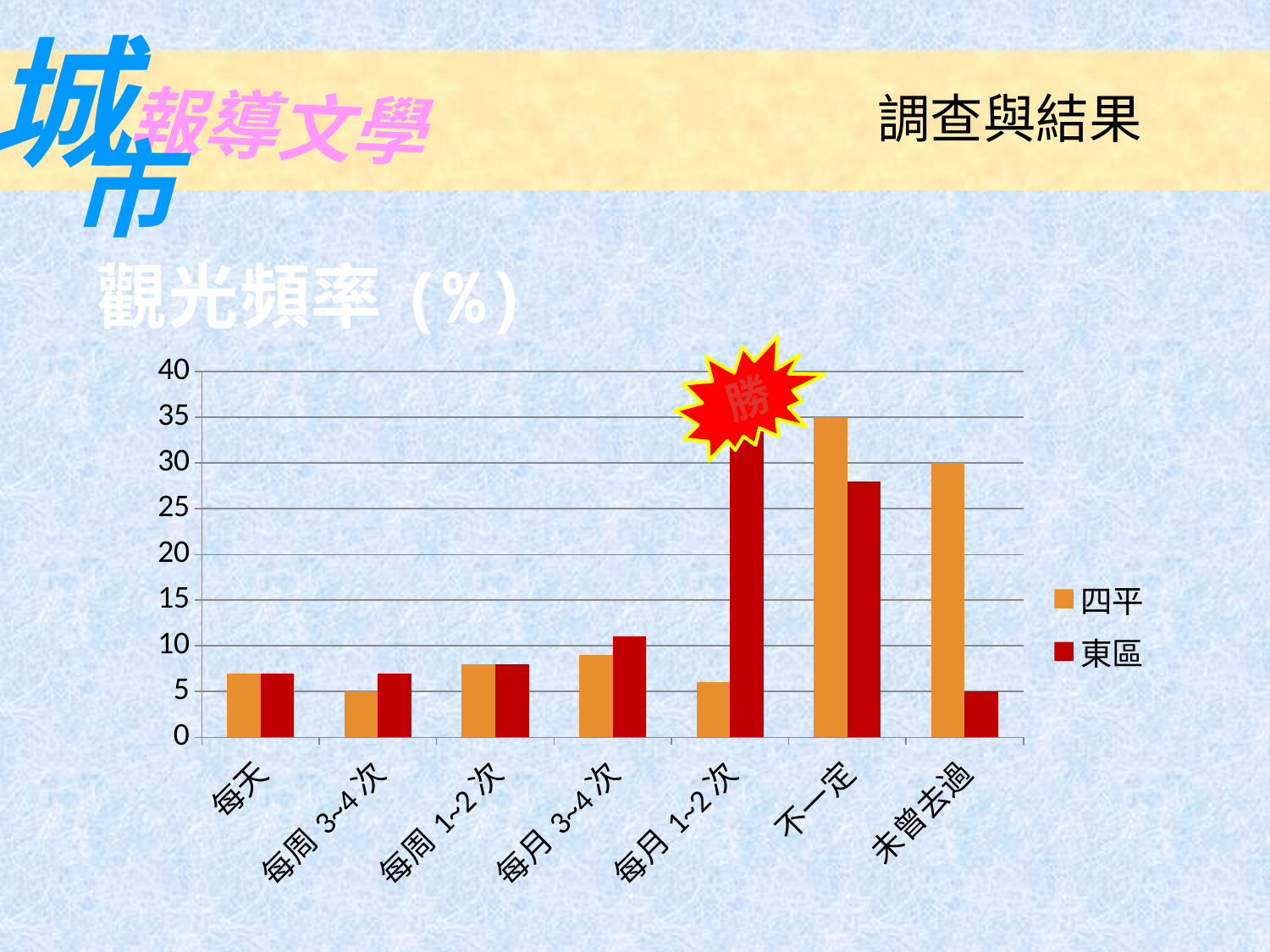
What is the value for 四平 in the 不一定 category? 35 What is the value for 四平 in the 未曾去過 category? 30 Which category has the lowest value for 東區? 未曾去過 How many categories are shown on the x axis? 7 What kind of chart is shown on the slide? bar chart What is the value for 東區 in the 未曾去過 category? 5 What is the title of the chart? 觀光頻率（%） How many series does the legend list? 2 In the 每月 1~2次 category, which series has the larger value, 四平 or 東區? 東區 Is the value for 東區 in the 不一定 category greater or less than 25? greater Which category has the highest value for 四平? 不一定 Which category has the highest value for 東區? 每月 1~2次